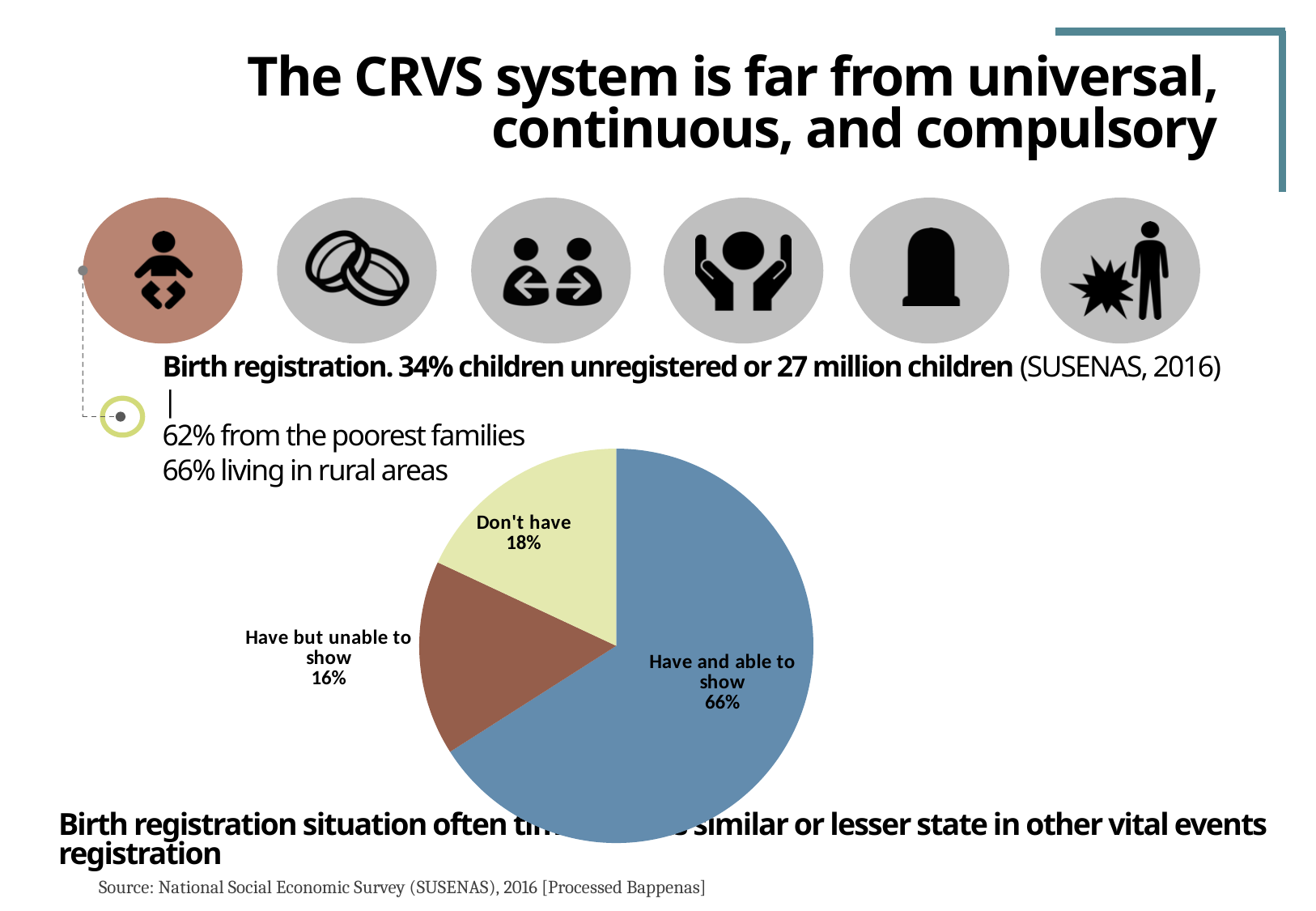
What kind of chart is shown on the slide? pie chart What colour is the 'Have and able to show' slice? blue What is the difference in percentage points between 'Don't have' and 'Have but unable to show'? 2 What percentage of children are in the 'Don't have' category? 18% What percentage of children are in the 'Have and able to show' category? 66% What is the combined share of 'Don't have' and 'Have but unable to show'? 34% Which category has the largest share of the pie? Have and able to show What percentage of children are in the 'Have but unable to show' category? 16% What is the difference in percentage points between 'Have and able to show' and 'Don't have'? 48 Which category has the smallest share of the pie? Have but unable to show How many slices does the pie chart have? 3 Which is larger: the share for 'Have and able to show' or the share for 'Have but unable to show'? Have and able to show